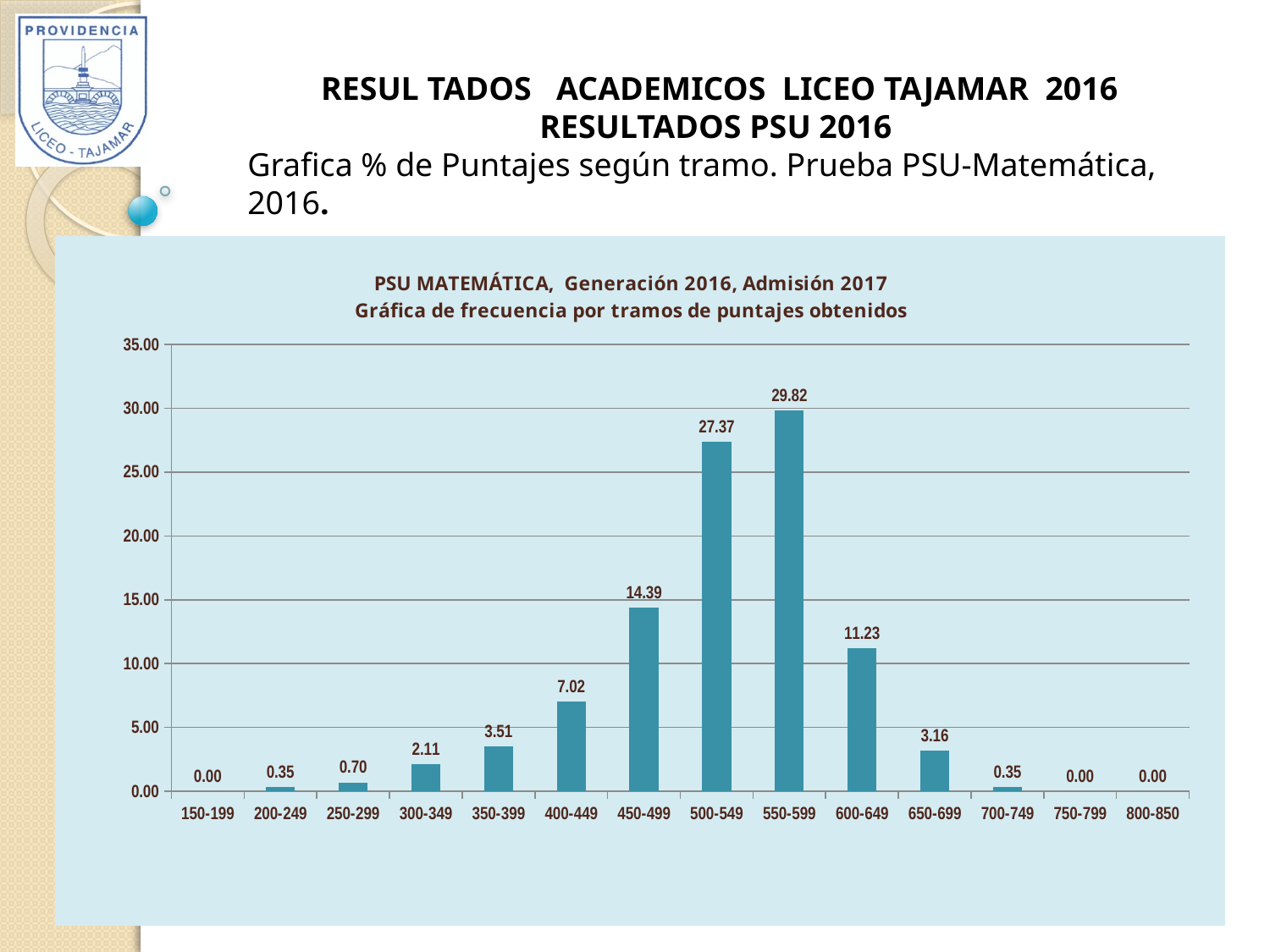
Is the value for 500-549 greater or less than 25.00? greater What is the value for the 550-599 score range? 29.82 What is the value for the 450-499 score range? 14.39 Which score range has the highest value? 550-599 What is the difference between the values for 600-649 and 650-699? 8.07 How many score ranges have a value of 0.00? 3 How many score ranges are shown on the x axis? 14 What is the difference between the values for 550-599 and 500-549? 2.45 What kind of chart is shown on the slide? bar chart Do the values rise or fall from 550-599 to 800-850? fall What is the value for the 300-349 score range? 2.11 Which is larger, the value for 400-449 or the value for 600-649? 600-649